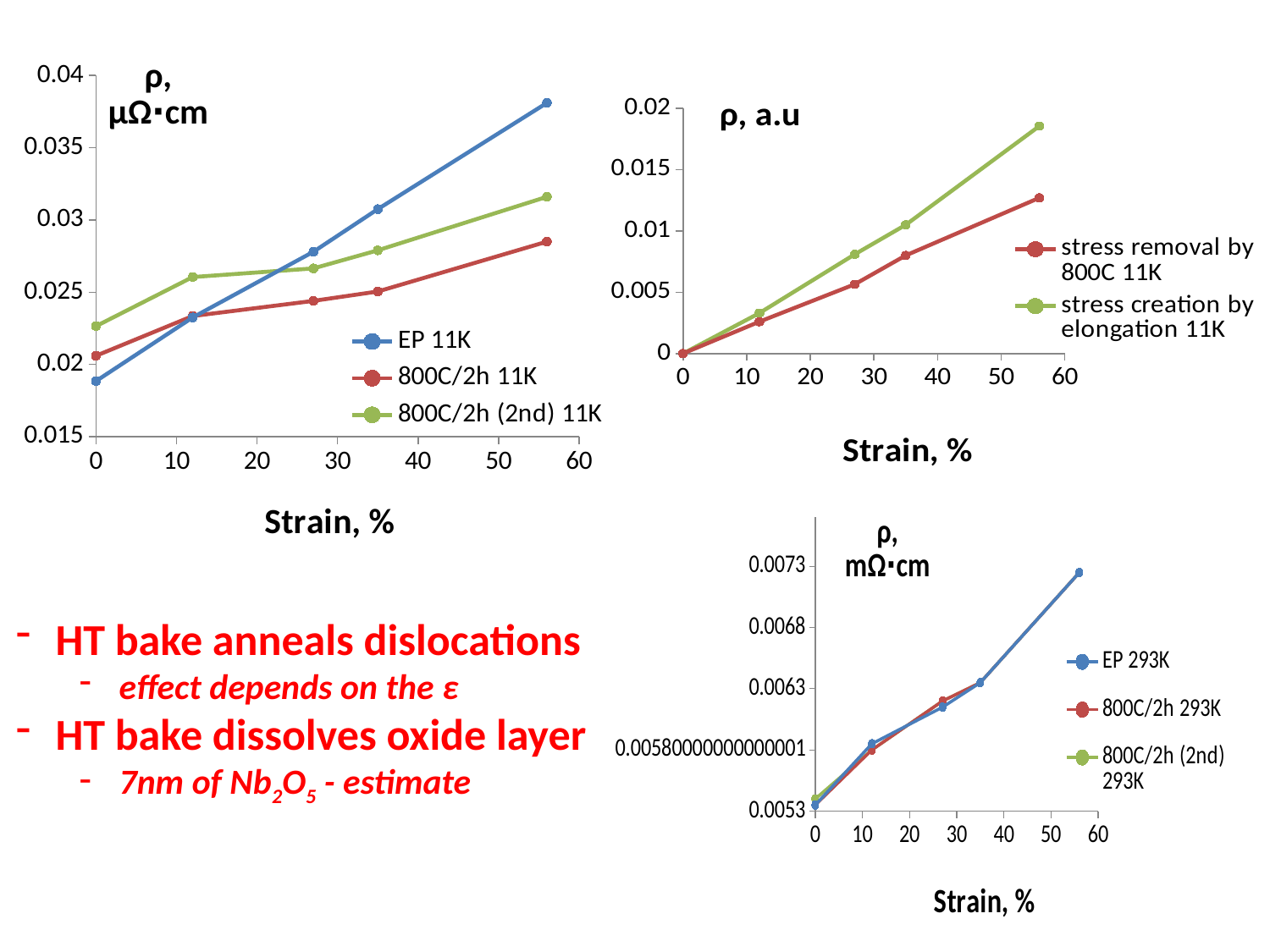
In the top-left chart (ρ, μΩ·cm), is the value of 800C/2h 11K at 56% strain greater or less than 0.03? less In the top-left chart (ρ, μΩ·cm), which series has the highest value at 56% strain? EP 11K In the top-right chart (ρ, a.u), how many series does the legend list? 2 In the top-left chart (ρ, μΩ·cm), how many series does the legend list? 3 In the bottom-right chart (ρ, mΩ·cm), how many data points does the EP 293K series have? 5 In the top-right chart (ρ, a.u), is the value of stress creation by elongation 11K at 56% strain greater or less than 0.015? greater What type of chart is the bottom-right chart (ρ, mΩ·cm)? line chart In the top-right chart (ρ, a.u), which series is higher at 56% strain: stress removal by 800C 11K or stress creation by elongation 11K? stress creation by elongation 11K In the top-left chart (ρ, μΩ·cm), which series has the lowest value at 0% strain? EP 11K In the top-left chart (ρ, μΩ·cm), does the EP 11K series rise or fall as strain increases? rise In the top-left chart (ρ, μΩ·cm), is the value of EP 11K at 56% strain greater or less than 0.035? greater